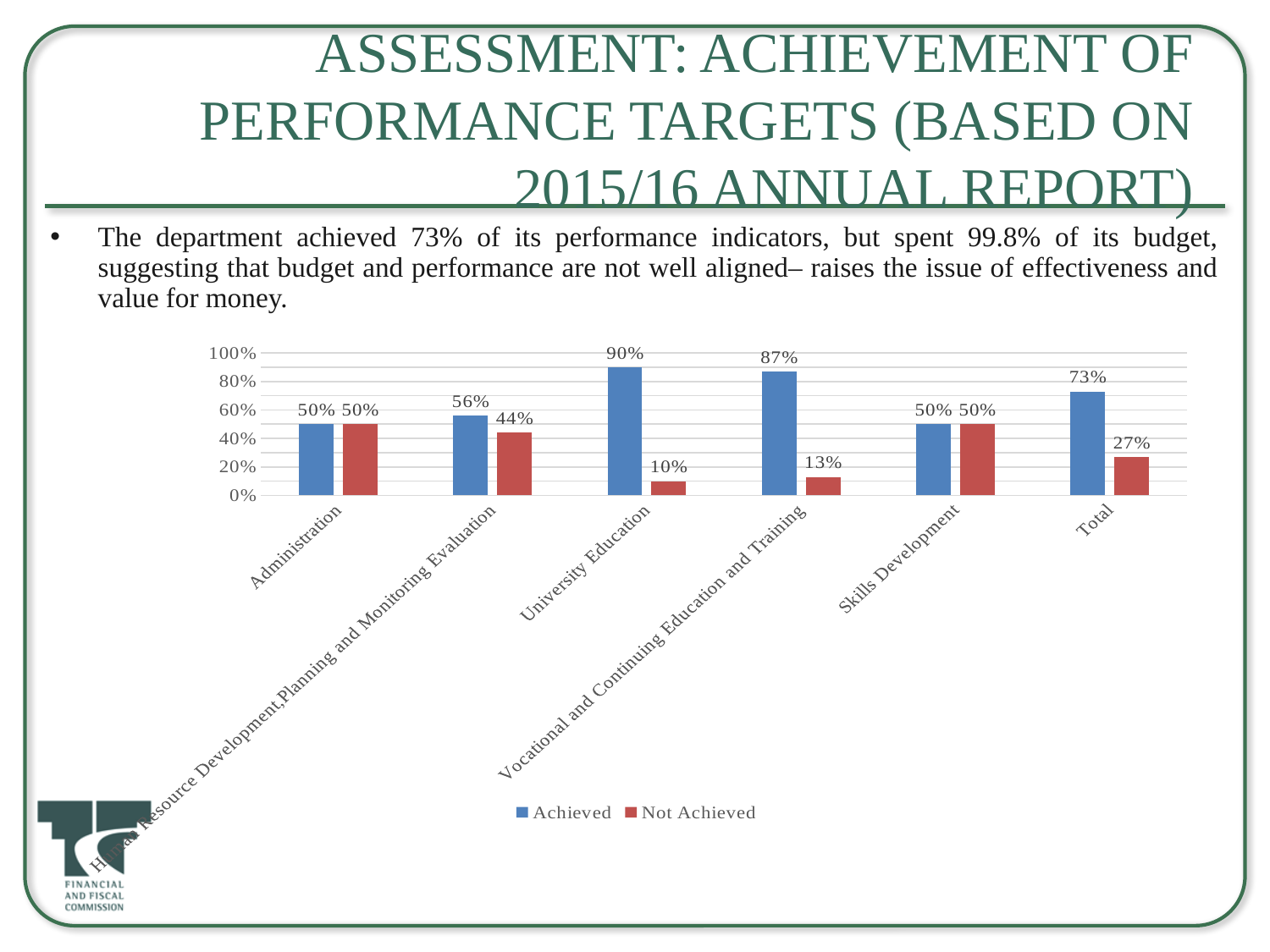
How many series does the legend list? 2 What is the Achieved value for University Education? 90% What is the Not Achieved value for Vocational and Continuing Education and Training? 13% What is the difference between the Achieved value for University Education and the Achieved value for Total? 17% What type of chart is shown on the slide? bar chart What is the Achieved value for Total? 73% Which is larger: the Achieved value for Vocational and Continuing Education and Training or the Achieved value for Skills Development? Vocational and Continuing Education and Training What is the difference between the Achieved and Not Achieved values for the category ending in 'Planning and Monitoring Evaluation'? 12% Which category has the highest Achieved value? University Education Which category has the lowest Not Achieved value? University Education Which series is shown in red in the chart? Not Achieved How many categories are shown on the x axis of the chart? 6